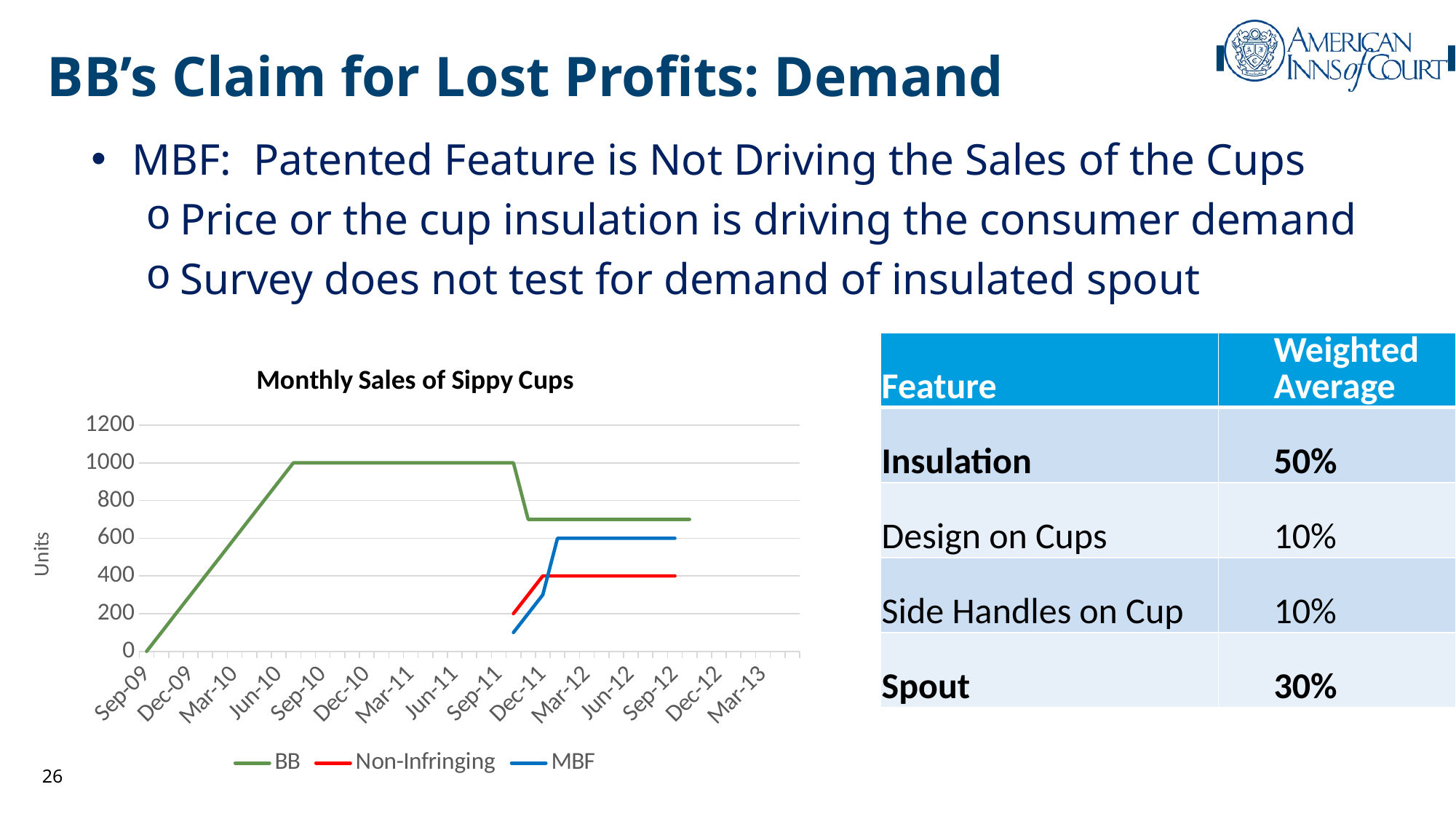
In the "Monthly Sales of Sippy Cups" chart, what is the value of MBF at Jun-12? 600 What kind of chart is "Monthly Sales of Sippy Cups"? line chart How many series does the legend of the "Monthly Sales of Sippy Cups" chart list? 3 In the "Monthly Sales of Sippy Cups" chart, what is the difference between MBF and Non-Infringing at Jun-12? 200 What is the label on the vertical axis of the "Monthly Sales of Sippy Cups" chart? Units Which series in the "Monthly Sales of Sippy Cups" chart is drawn in green? BB In the "Monthly Sales of Sippy Cups" chart, what is the value of BB at Mar-11? 1000 In the "Monthly Sales of Sippy Cups" chart, is the value for BB at Jun-12 greater or less than 800? less In the "Monthly Sales of Sippy Cups" chart, which series has the lowest value at Jun-12? Non-Infringing In the "Monthly Sales of Sippy Cups" chart, what is the value of Non-Infringing at Jun-12? 400 In the "Monthly Sales of Sippy Cups" chart, what is the value of BB at Sep-09? 0 In the "Monthly Sales of Sippy Cups" chart, which series has the highest value at Mar-12? BB